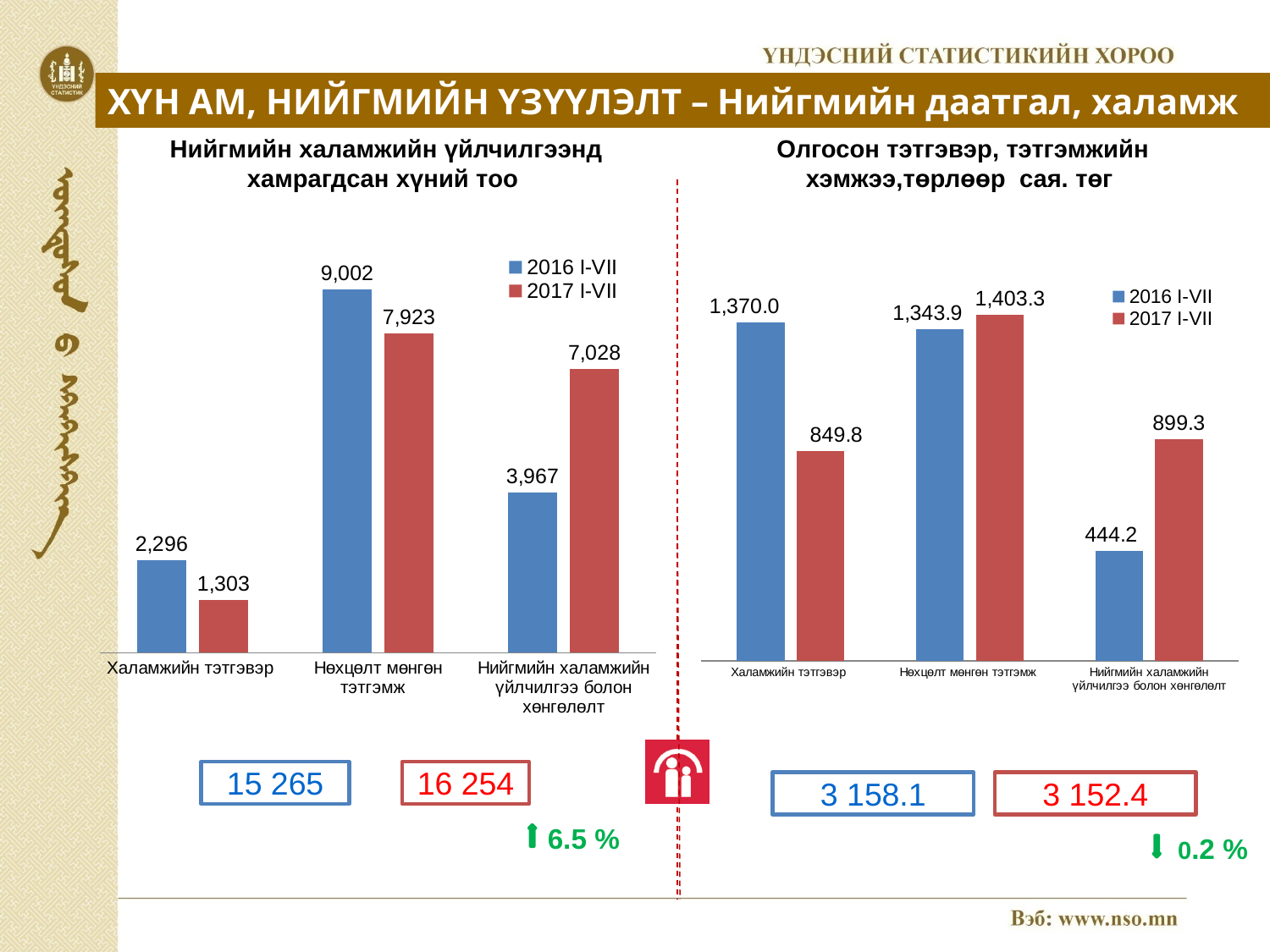
In the left chart (Нийгмийн халамжийн үйлчилгээнд хамрагдсан хүний тоо), what is the value for Халамжийн тэтгэвэр in 2017 I-VII? 1,303 In the left chart (Нийгмийн халамжийн үйлчилгээнд хамрагдсан хүний тоо), what is the value for Нөхцөлт мөнгөн тэтгэмж in 2016 I-VII? 9,002 How many series does the legend of the left chart (Нийгмийн халамжийн үйлчилгээнд хамрагдсан хүний тоо) list? 2 In the left chart (Нийгмийн халамжийн үйлчилгээнд хамрагдсан хүний тоо), which is larger for Халамжийн тэтгэвэр: the 2016 I-VII value or the 2017 I-VII value? 2016 I-VII In the left chart (Нийгмийн халамжийн үйлчилгээнд хамрагдсан хүний тоо), what is the difference between the 2016 I-VII and 2017 I-VII values for Нийгмийн халамжийн үйлчилгээ болон хөнгөлөлт? 3,061 In the right chart (Олгосон тэтгэвэр, тэтгэмжийн хэмжээ, төрлөөр сая. төг), which category has the lowest value for 2016 I-VII? Нийгмийн халамжийн үйлчилгээ болон хөнгөлөлт How many categories are shown on the x axis of the right chart (Олгосон тэтгэвэр, тэтгэмжийн хэмжээ, төрлөөр сая. төг)? 3 In the left chart (Нийгмийн халамжийн үйлчилгээнд хамрагдсан хүний тоо), which category has the highest value for 2017 I-VII? Нөхцөлт мөнгөн тэтгэмж In the right chart (Олгосон тэтгэвэр, тэтгэмжийн хэмжээ, төрлөөр сая. төг), what is the value for Халамжийн тэтгэвэр in 2016 I-VII? 1,370.0 What kind of chart is the right chart (Олгосон тэтгэвэр, тэтгэмжийн хэмжээ, төрлөөр сая. төг)? Bar chart In the right chart (Олгосон тэтгэвэр, тэтгэмжийн хэмжээ, төрлөөр сая. төг), what is the difference between the 2016 I-VII and 2017 I-VII values for Халамжийн тэтгэвэр? 520.2 In the right chart (Олгосон тэтгэвэр, тэтгэмжийн хэмжээ, төрлөөр сая. төг), what is the value for Нийгмийн халамжийн үйлчилгээ болон хөнгөлөлт in 2017 I-VII? 899.3